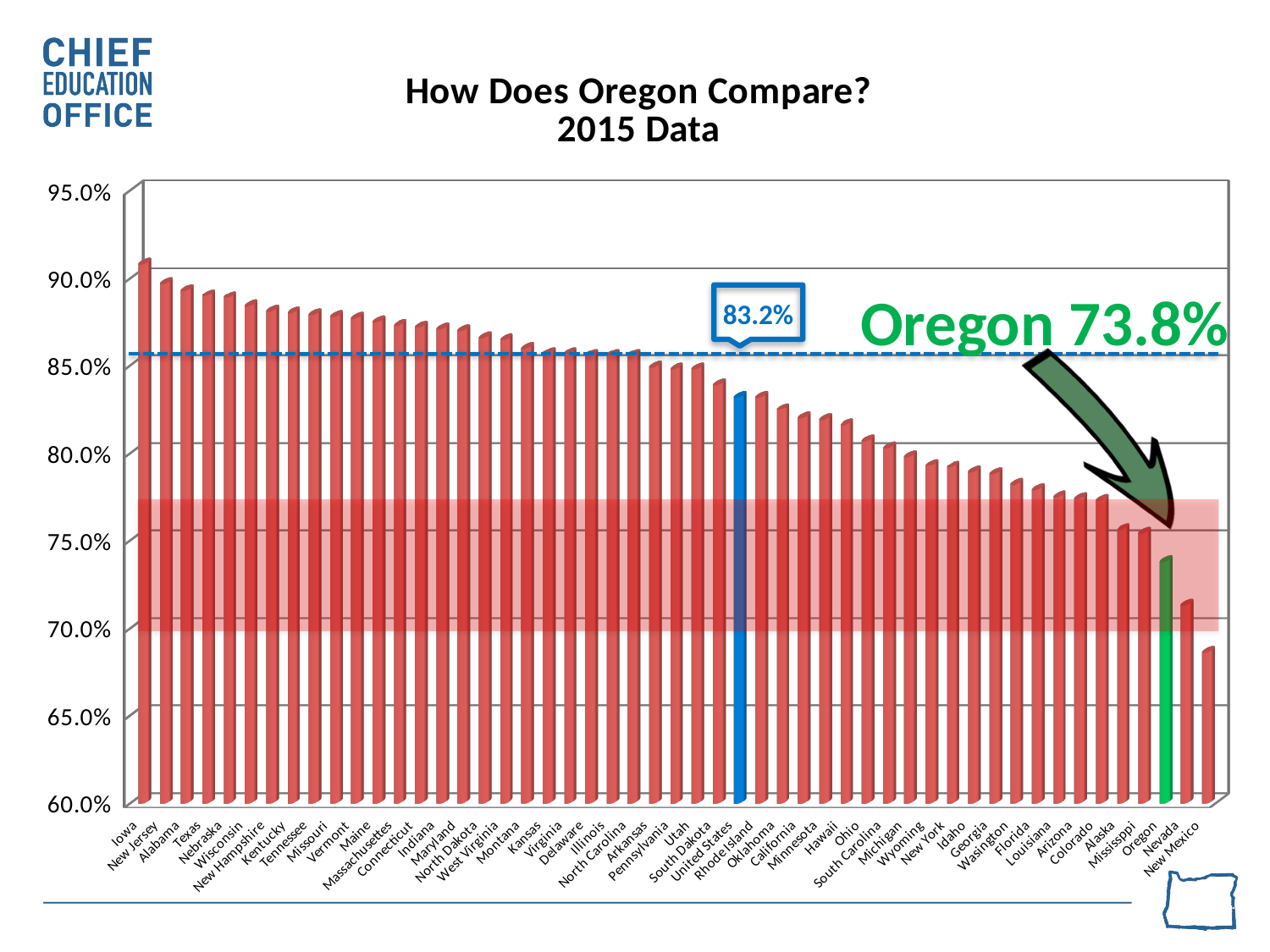
What is the value shown for Oregon? 73.8% Do the bar values rise or fall moving from left to right along the x axis? Fall What is the title of the chart? How Does Oregon Compare? 2015 Data Which state has the lowest bar in the chart? New Mexico Is the value for Hawaii greater or less than 80.0%? greater Which has the larger value, Oregon or Nevada? Oregon Is the value for Alabama greater or less than 85.0%? greater What value is shown in the callout above the United States bar? 83.2% What is the difference between the United States value (83.2%) and the Oregon value (73.8%)? 9.4 percentage points Which state has the highest bar in the chart? Iowa What kind of chart is shown on the slide? Bar chart Is the value for New Mexico greater or less than 70.0%? less